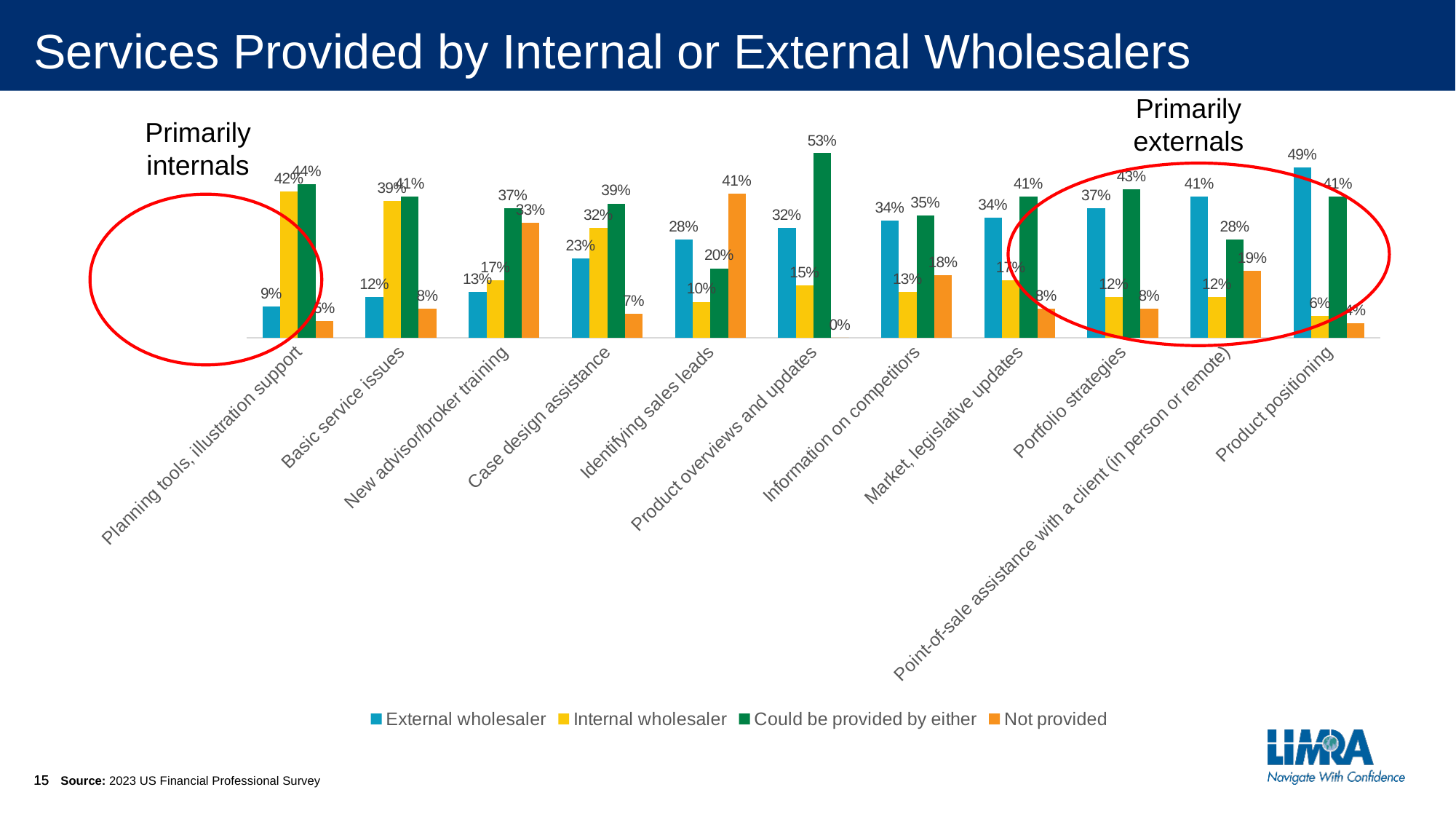
What is the Not provided value for Identifying sales leads? 41% What is the External wholesaler value for Product positioning? 49% How many series does the legend list? 4 Which category has the lowest External wholesaler value? Planning tools, illustration support What kind of chart is shown on the slide? Bar chart What is the Not provided value for New advisor/broker training? 33% What is the title of the chart? Services Provided by Internal or External Wholesalers How many service categories are shown on the x axis? 11 What is the 'Could be provided by either' value for Product overviews and updates? 53% What is the difference between the Internal wholesaler and External wholesaler values for Planning tools, illustration support? 33 percentage points Which category has the highest 'Could be provided by either' value? Product overviews and updates For Point-of-sale assistance with a client (in person or remote), which is larger: External wholesaler or Could be provided by either? External wholesaler